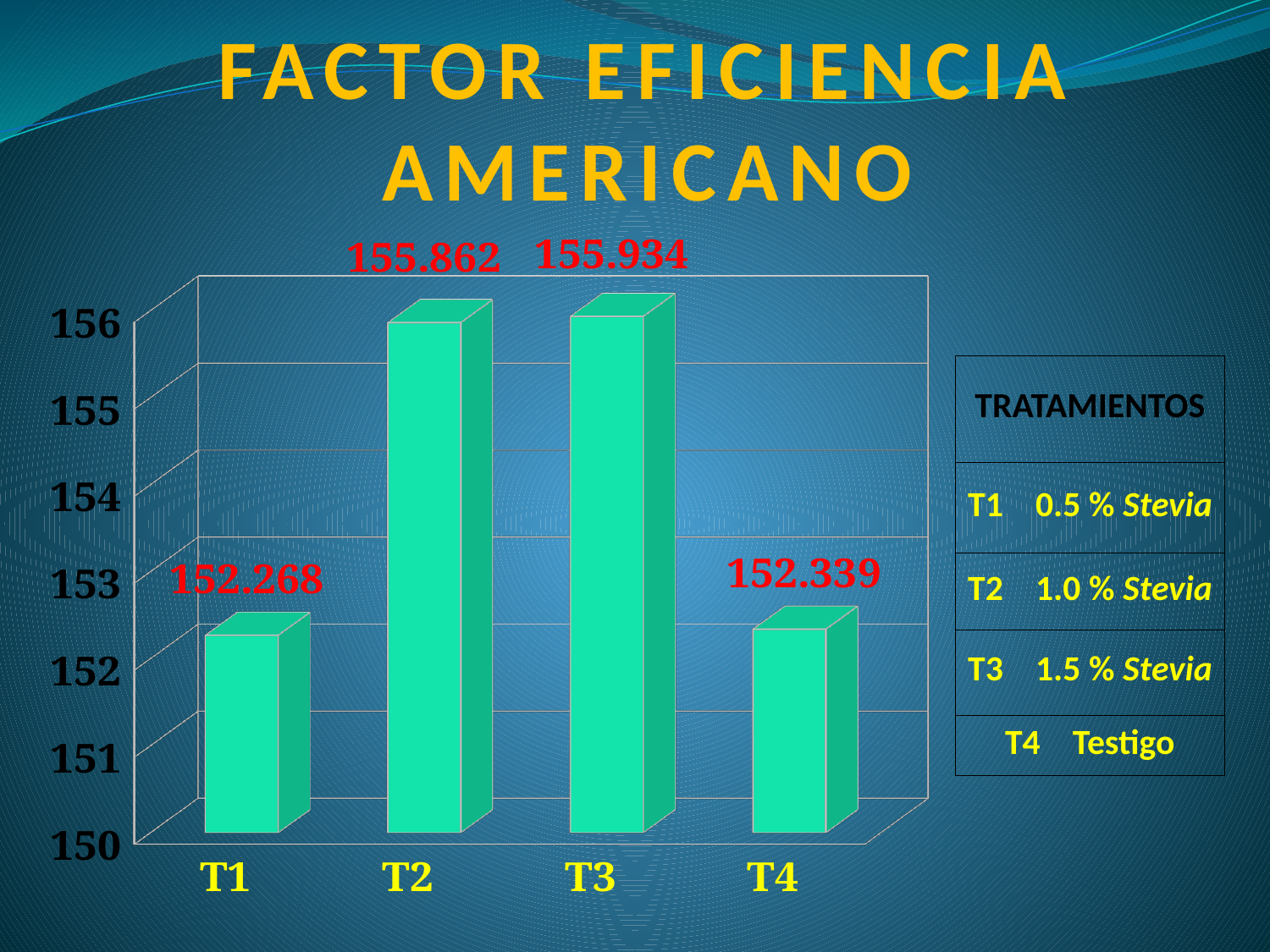
What is the difference between the values for T3 and T1? 3.666 What is the value for T1? 152.268 Which treatment has the lowest value? T1 What is the value for T3? 155.934 According to the table on the slide, what does T4 represent? Testigo Which is larger, the value for T2 or the value for T4? T2 How many treatments are shown on the x axis? 4 What is the value for T4? 152.339 Which treatment has the highest value? T3 Is the value for T1 greater or less than 153? less What is the value for T2? 155.862 What kind of chart is shown on the slide? bar chart